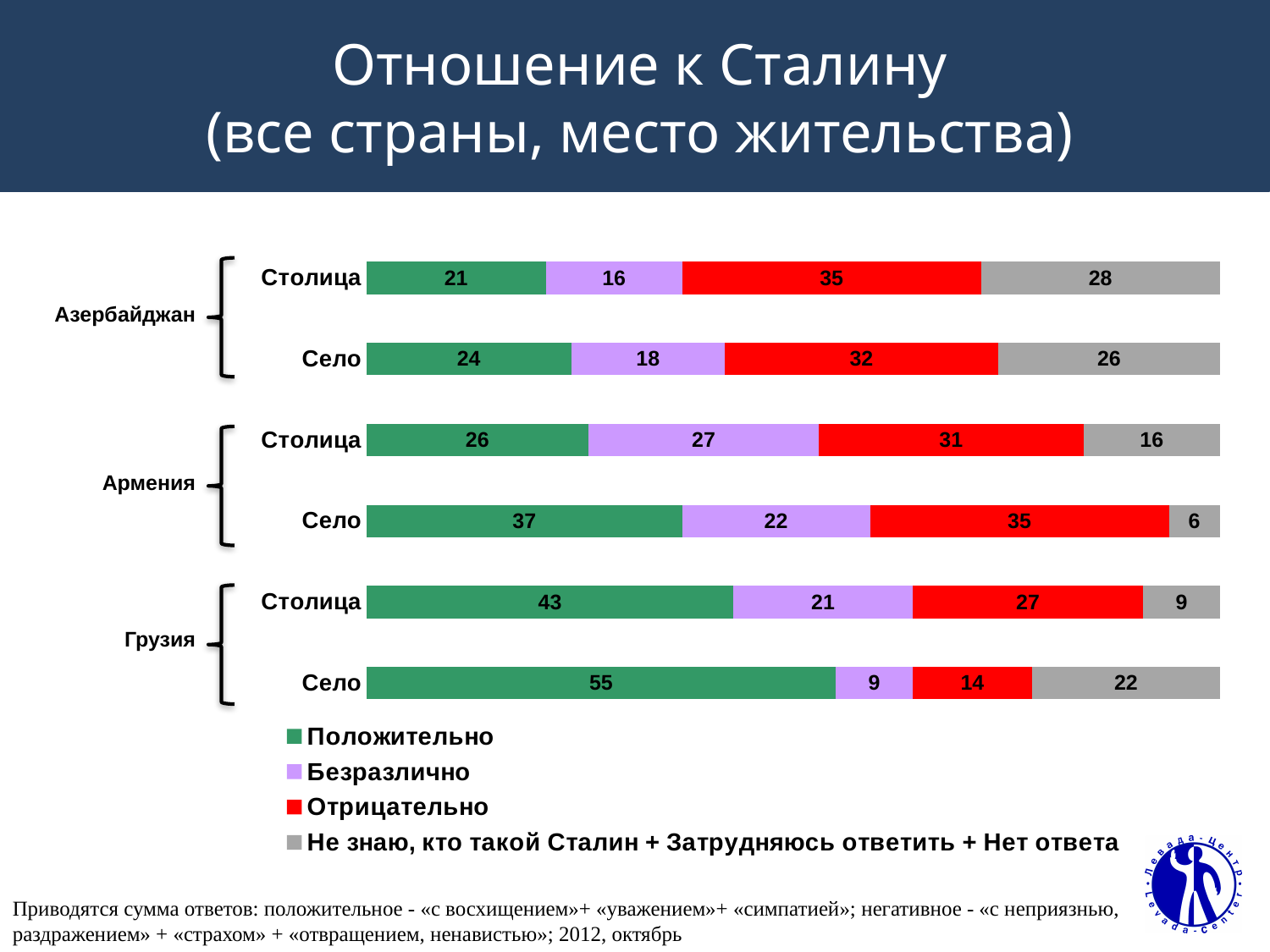
What is the total of the stacked bar for Азербайджан, Столица? 100 What is the value of «Отрицательно» for Азербайджан, Столица? 35 How many bars are plotted in the chart? 6 What is the difference between the «Положительно» values for Грузия Село and Грузия Столица? 12 Which bar has the highest «Положительно» value? Грузия, Село What colour represents «Отрицательно» in the legend? Red Which bar has the lowest value for «Не знаю, кто такой Сталин + Затрудняюсь ответить + Нет ответа»? Армения, Село What is the value of «Положительно» for Грузия, Село? 55 What is the value of «Безразлично» for Армения, Столица? 27 How many series does the legend list? 4 What kind of chart is shown on the slide? Stacked bar chart Which is larger: the «Безразлично» value for Армения Столица or for Азербайджан Село? Армения Столица